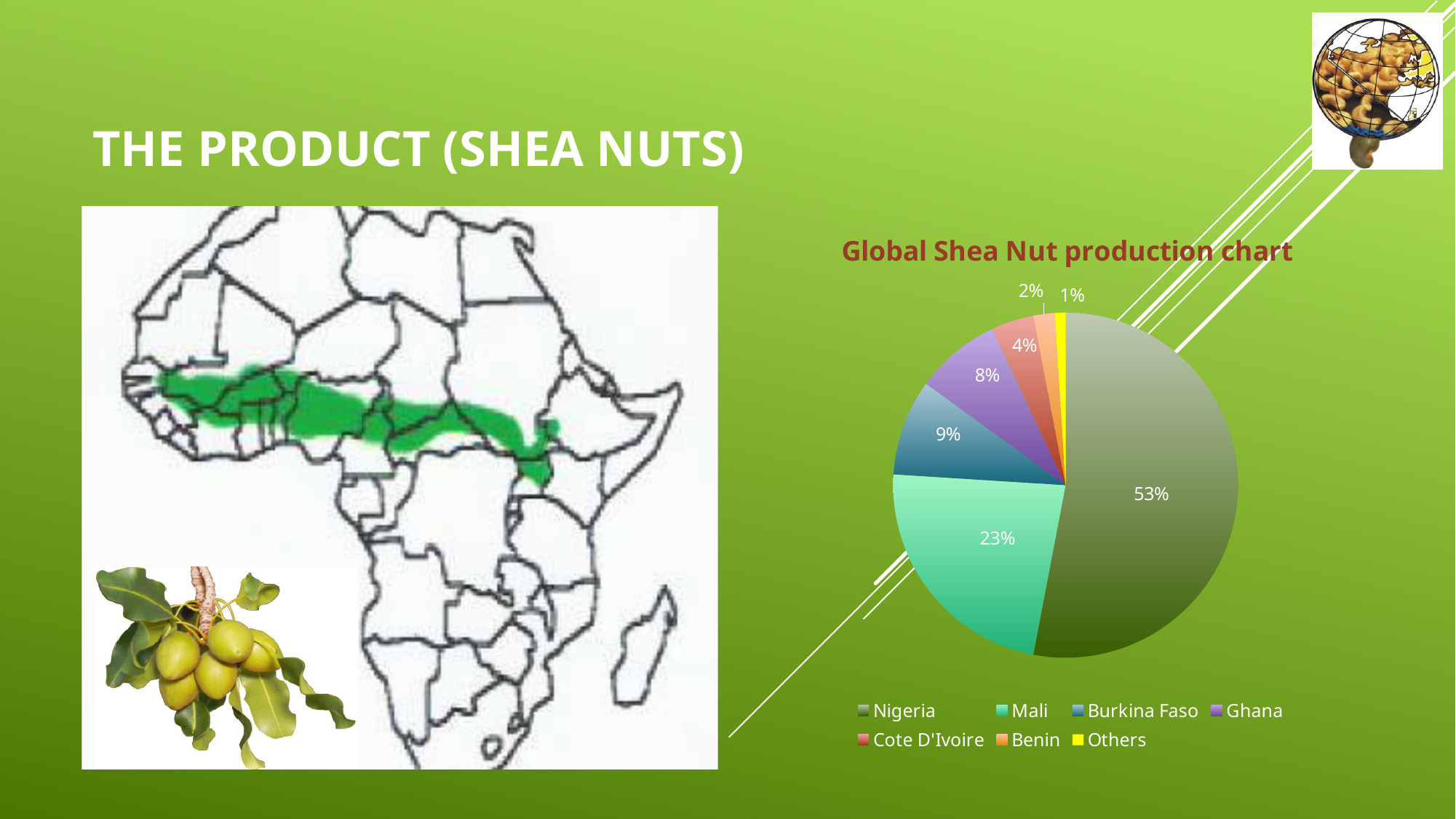
What type of chart is shown on the slide? pie chart What is the title of the chart? Global Shea Nut production chart Which country has the largest share of global shea nut production? Nigeria How many categories are listed in the chart legend? 7 What share of global shea nut production does Cote D'Ivoire have? 4% Which has a larger share of production, Burkina Faso or Ghana? Burkina Faso What share of global shea nut production does Burkina Faso have? 9% What share of global shea nut production does Nigeria have? 53% What share of global shea nut production does Mali have? 23% What share of global shea nut production does Ghana have? 8% What is the difference between Nigeria's share and Mali's share? 30% Which category has the smallest slice in the pie chart? Others